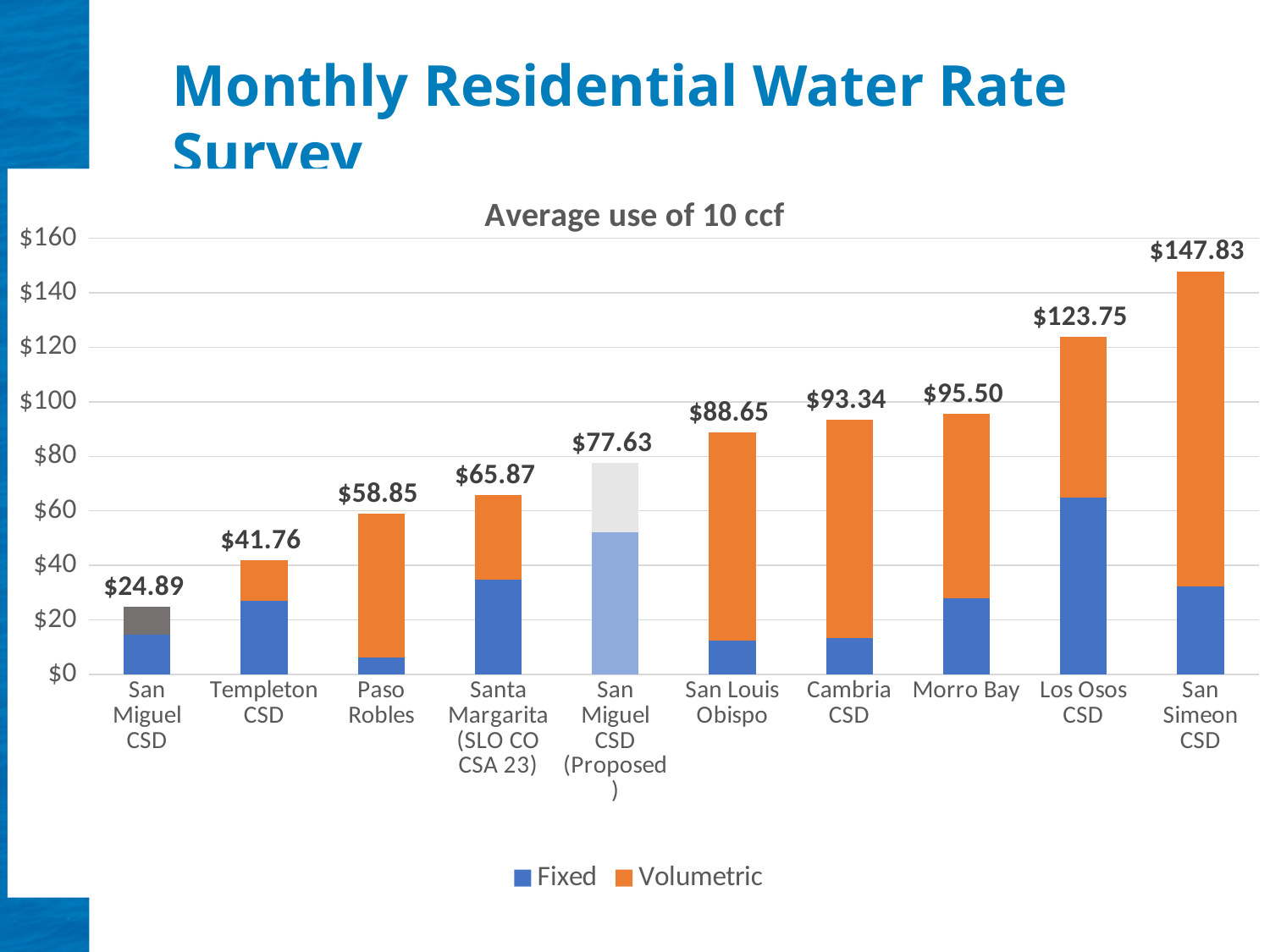
How many series does the legend list? 2 What is the subtitle printed above the chart? Average use of 10 ccf What is the difference between the total rate for San Miguel CSD (Proposed) and the current San Miguel CSD rate? $52.74 What is the total monthly water rate shown for Morro Bay? $95.50 What is the total monthly water rate shown for San Simeon CSD? $147.83 What kind of chart is shown on the slide? Stacked bar chart Which agency has the highest total monthly water rate? San Simeon CSD Which agency has the lowest total monthly water rate? San Miguel CSD What is the total monthly water rate shown for San Miguel CSD (Proposed)? $77.63 Which has a higher total monthly rate, Cambria CSD or San Louis Obispo? Cambria CSD Is the Fixed portion of the Los Osos CSD bar greater or less than $60? greater How many agencies are shown on the x axis of the chart? 10